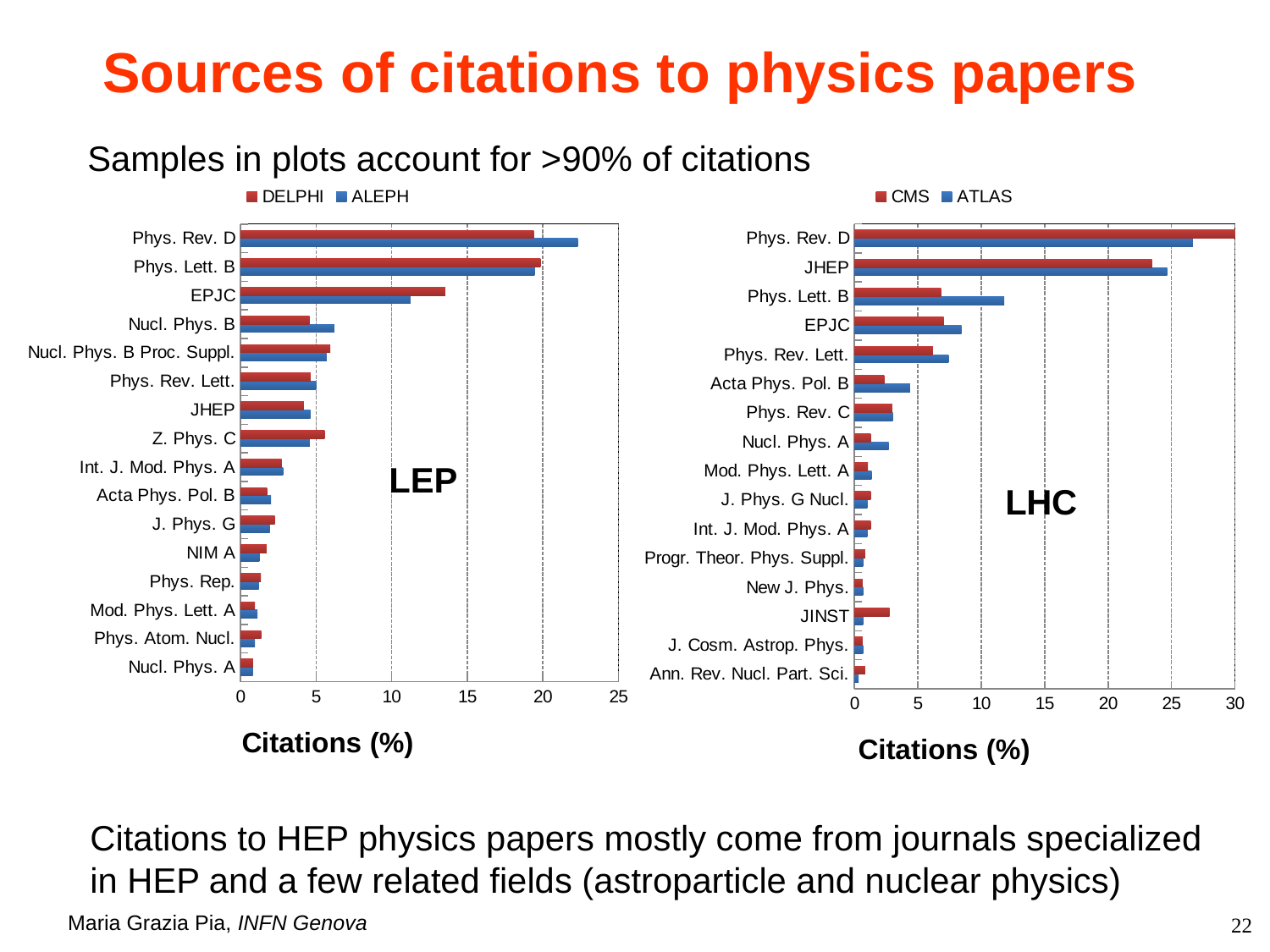
How many journal categories are plotted in the LHC chart on the right? 16 What kind of chart is the LEP chart on the left? bar chart In the LEP chart on the left, which is larger for EPJC, the DELPHI value or the ALEPH value? DELPHI Which two series are shown in the legend of the LEP chart on the left? DELPHI and ALEPH In the LHC chart on the right, is the CMS value for Phys. Rev. D greater or less than 25? greater In the LHC chart on the right, which is larger for JINST, the CMS value or the ATLAS value? CMS In the LEP chart on the left, is the ALEPH value for Phys. Rev. D greater or less than 20? greater In the LEP chart on the left, which journal has the highest ALEPH value? Phys. Rev. D In the LHC chart on the right, which journal has the highest CMS value? Phys. Rev. D In the LHC chart on the right, is the CMS value for Phys. Lett. B greater or less than 10? less How many series does the legend of the LHC chart on the right list? 2 How many journal categories are plotted in the LEP chart on the left? 16